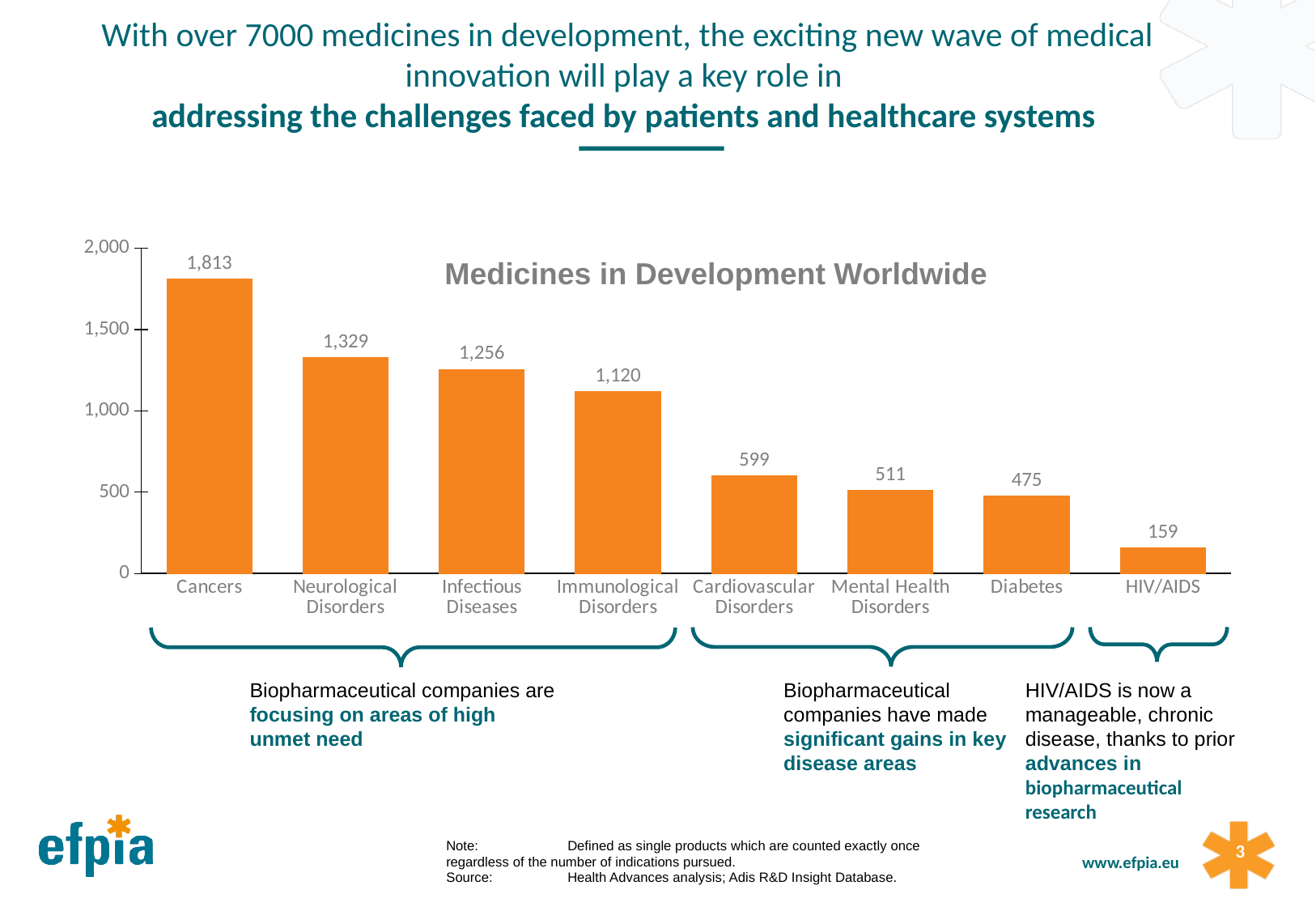
What is the value for Cancers in the Medicines in Development Worldwide chart? 1,813 Which category has the highest number of medicines in development? Cancers Which category has the lowest number of medicines in development? HIV/AIDS What is the title of the chart? Medicines in Development Worldwide Is the value for Cardiovascular Disorders greater or less than 500? greater How many medicines in development are shown for Diabetes? 475 What is the difference between the values for Mental Health Disorders and Diabetes? 36 What is the value for Cardiovascular Disorders? 599 Which is larger, the value for Infectious Diseases or Immunological Disorders? Infectious Diseases What kind of chart is shown on the slide? Bar chart How many categories are shown in the chart? 8 What is the difference between the values for Cancers and Neurological Disorders? 484